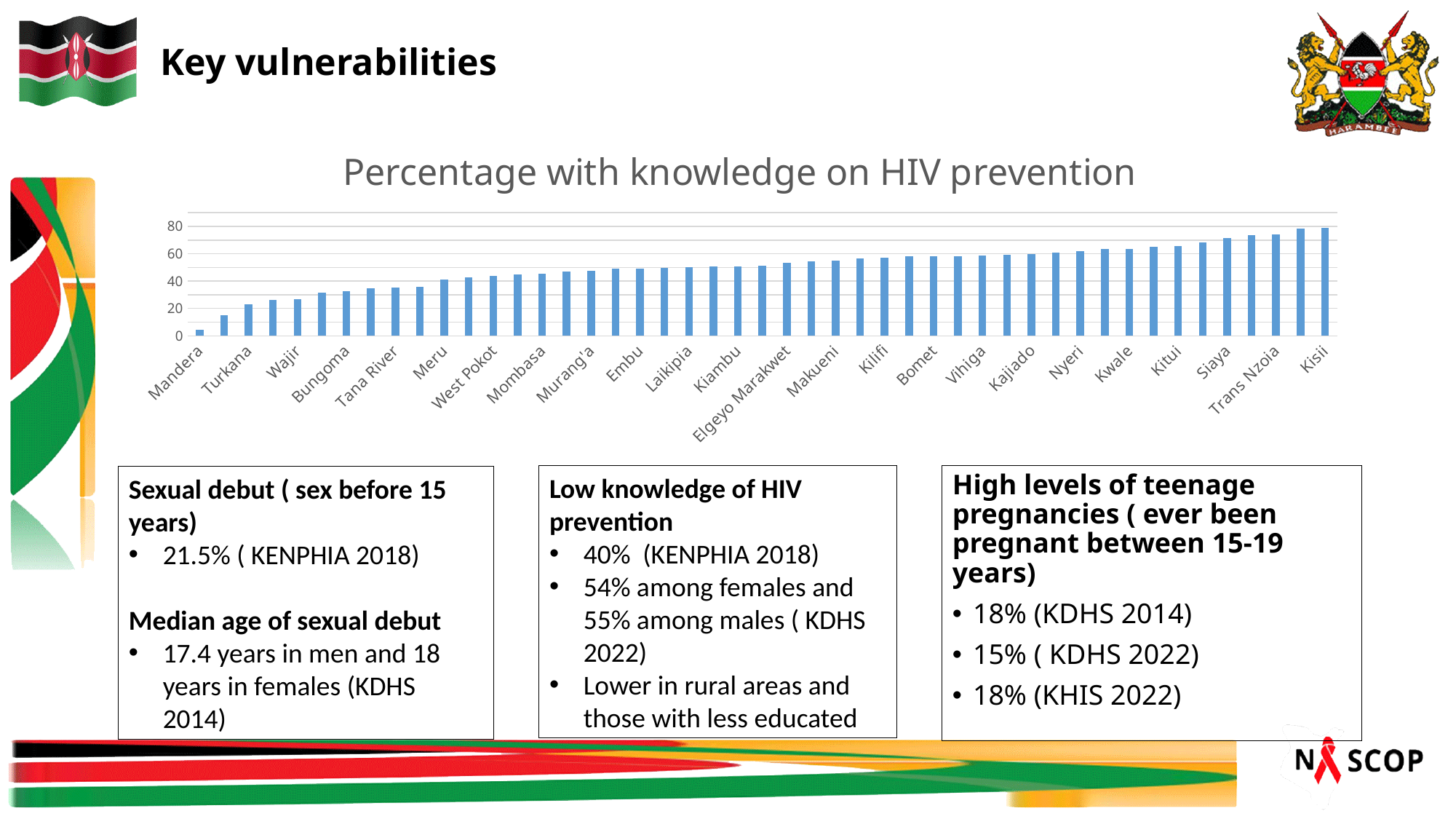
What kind of chart is shown on the slide? bar chart What is the title of the chart? Percentage with knowledge on HIV prevention Is the value for Mandera greater or less than 20? less Which county has the highest percentage with knowledge on HIV prevention? Kisii Do the values rise or fall moving from left to right along the x axis? rise Is the value for Tana River greater or less than 40? less Which county has the lowest percentage with knowledge on HIV prevention? Mandera Is the value for Wajir greater or less than 20? greater Which has a higher percentage with knowledge on HIV prevention, Turkana or Trans Nzoia? Trans Nzoia